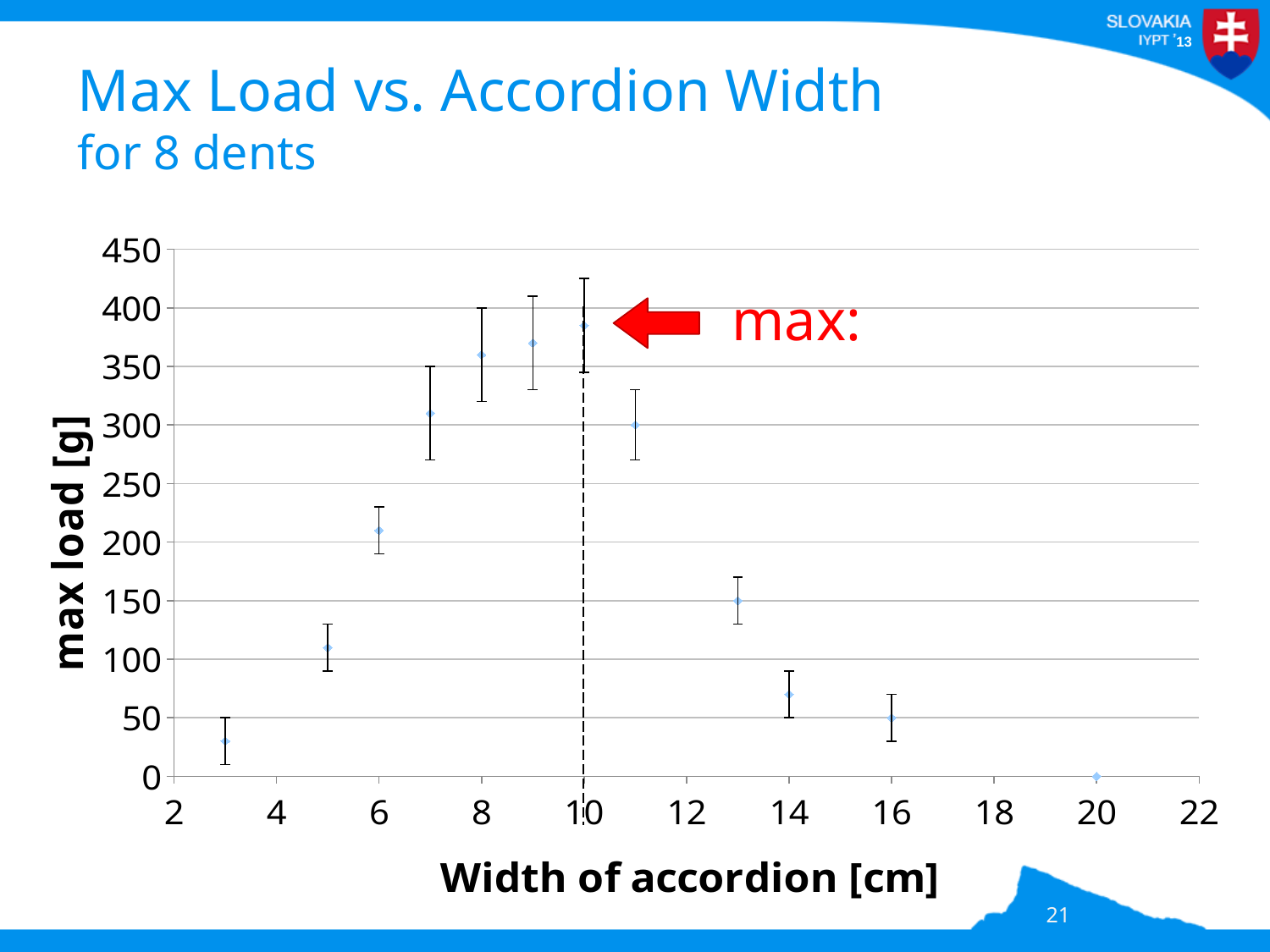
At which width of accordion is the max load lowest? 20 cm Is the max load at a width of 6 cm greater or less than 200 g? greater Is the max load at a width of 8 cm greater or less than 350 g? greater At which width of accordion is the max load highest? 10 cm What kind of chart is shown on the slide? scatter plot How many data points are plotted on the chart? 12 What is the title of the chart? Max Load vs. Accordion Width for 8 dents What is the label of the x axis? Width of accordion [cm] Which has a larger max load: a width of 7 cm or a width of 13 cm? 7 cm Is the max load at a width of 14 cm greater or less than 100 g? less Do the max load values rise or fall as the width increases from 10 cm to 20 cm? fall